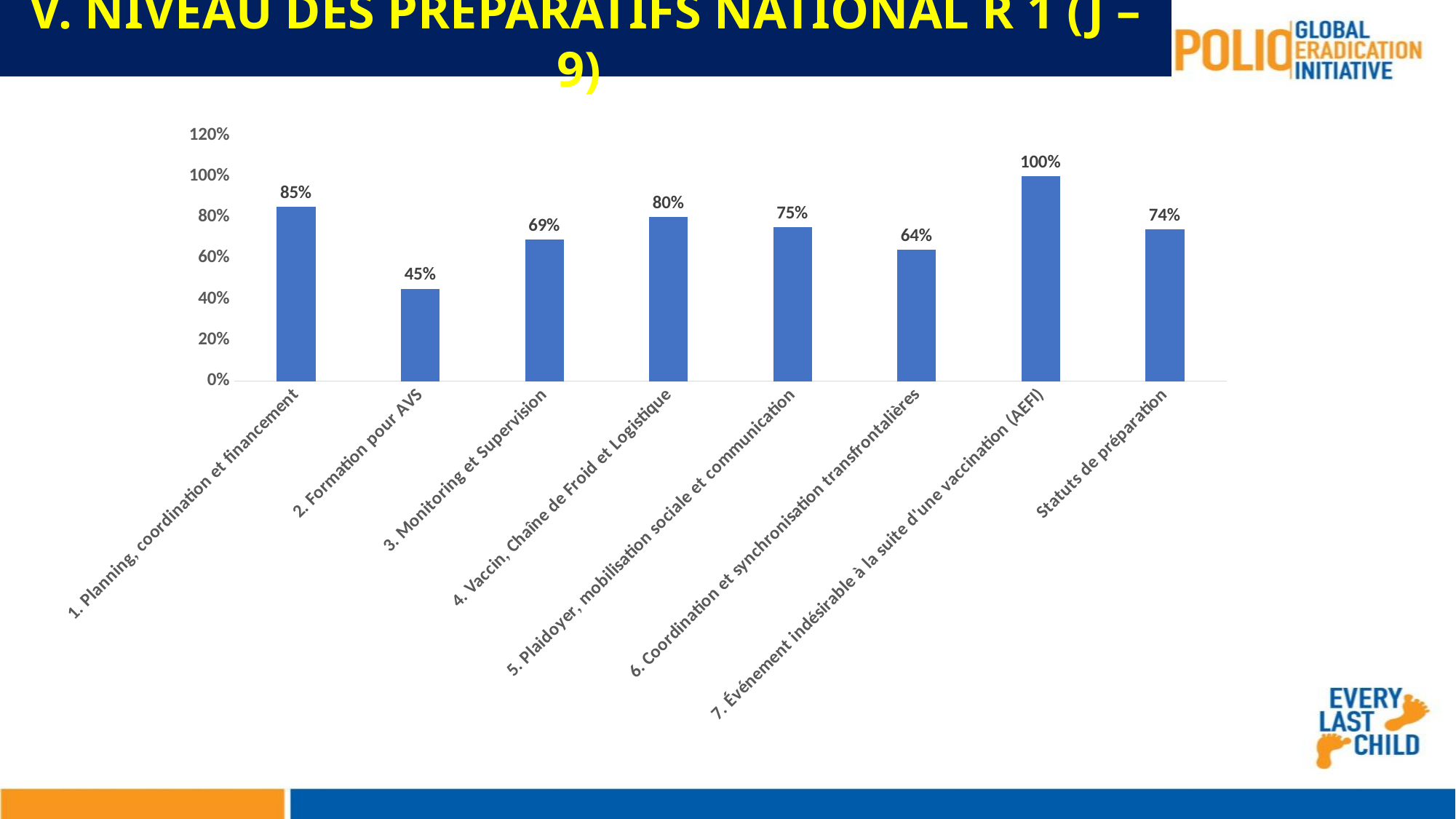
What is the difference between the values for "7. Événement indésirable à la suite d'une vaccination (AEFI)" and "Statuts de préparation"? 26% What is the value for "Statuts de préparation"? 74% Which is larger: the value for "3. Monitoring et Supervision" or the value for "6. Coordination et synchronisation transfrontalières"? 3. Monitoring et Supervision Is the value for "5. Plaidoyer, mobilisation sociale et communication" greater or less than 60%? greater What kind of chart is shown on the slide? Bar chart What is the value for "4. Vaccin, Chaîne de Froid et Logistique"? 80% Which category has the lowest value? 2. Formation pour AVS What is the difference between the values for "1. Planning, coordination et financement" and "2. Formation pour AVS"? 40% How many categories are shown on the x axis? 8 What is the highest tick value shown on the y axis? 120% What is the value for "2. Formation pour AVS"? 45% Which category has the highest value? 7. Événement indésirable à la suite d'une vaccination (AEFI)